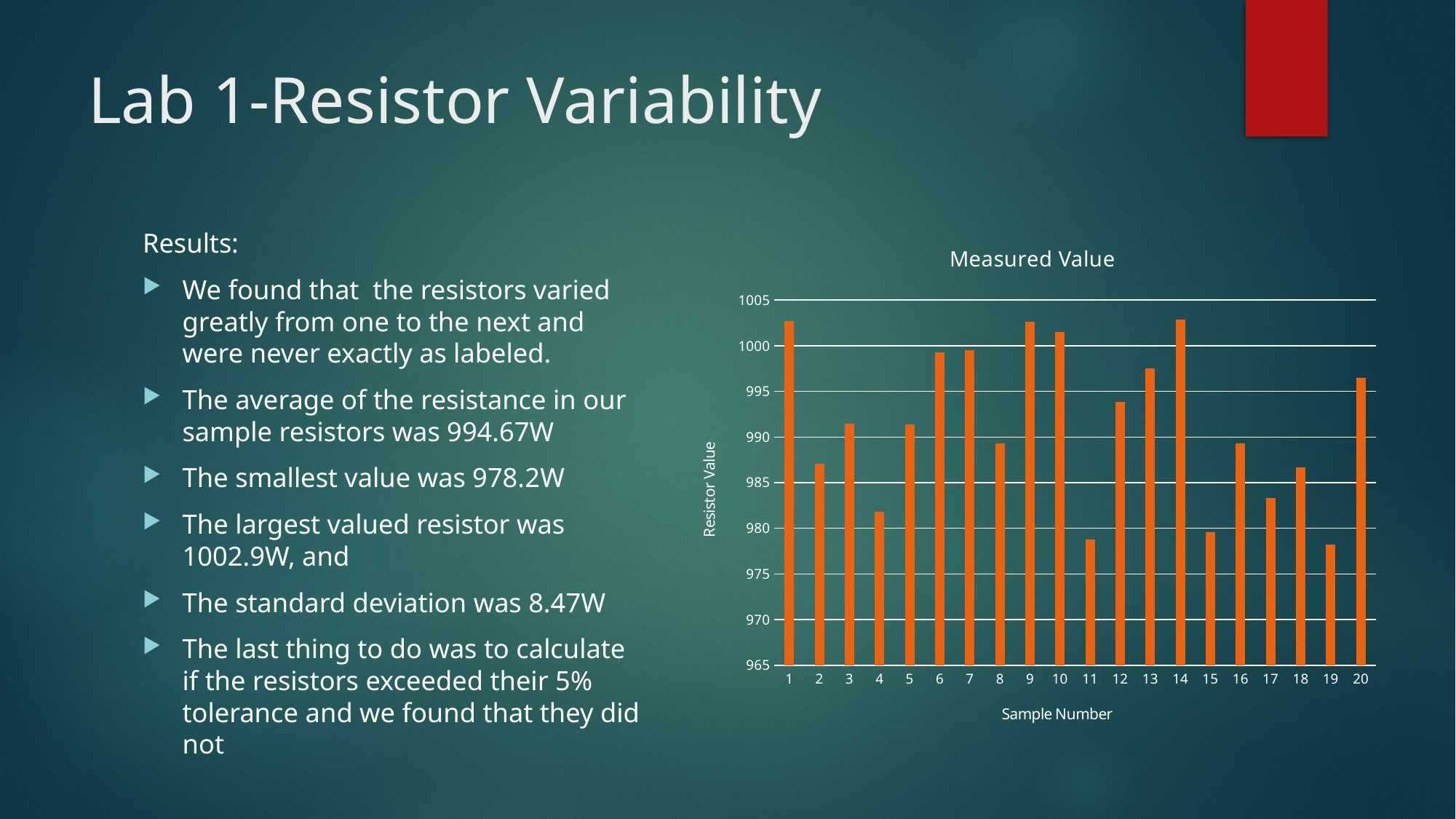
How many samples are plotted on the x axis of the chart? 20 What is the title of the chart? Measured Value Is the value for sample 10 greater or less than 1000? greater Is the value for sample 12 greater or less than 995? less What kind of chart is shown on the slide? bar chart Which has the larger value, sample 3 or sample 17? sample 3 Is the value for sample 20 greater or less than 995? greater What is the label of the x axis of the chart? Sample Number Which has the larger value, sample 6 or sample 8? sample 6 Which has the larger value, sample 14 or sample 15? sample 14